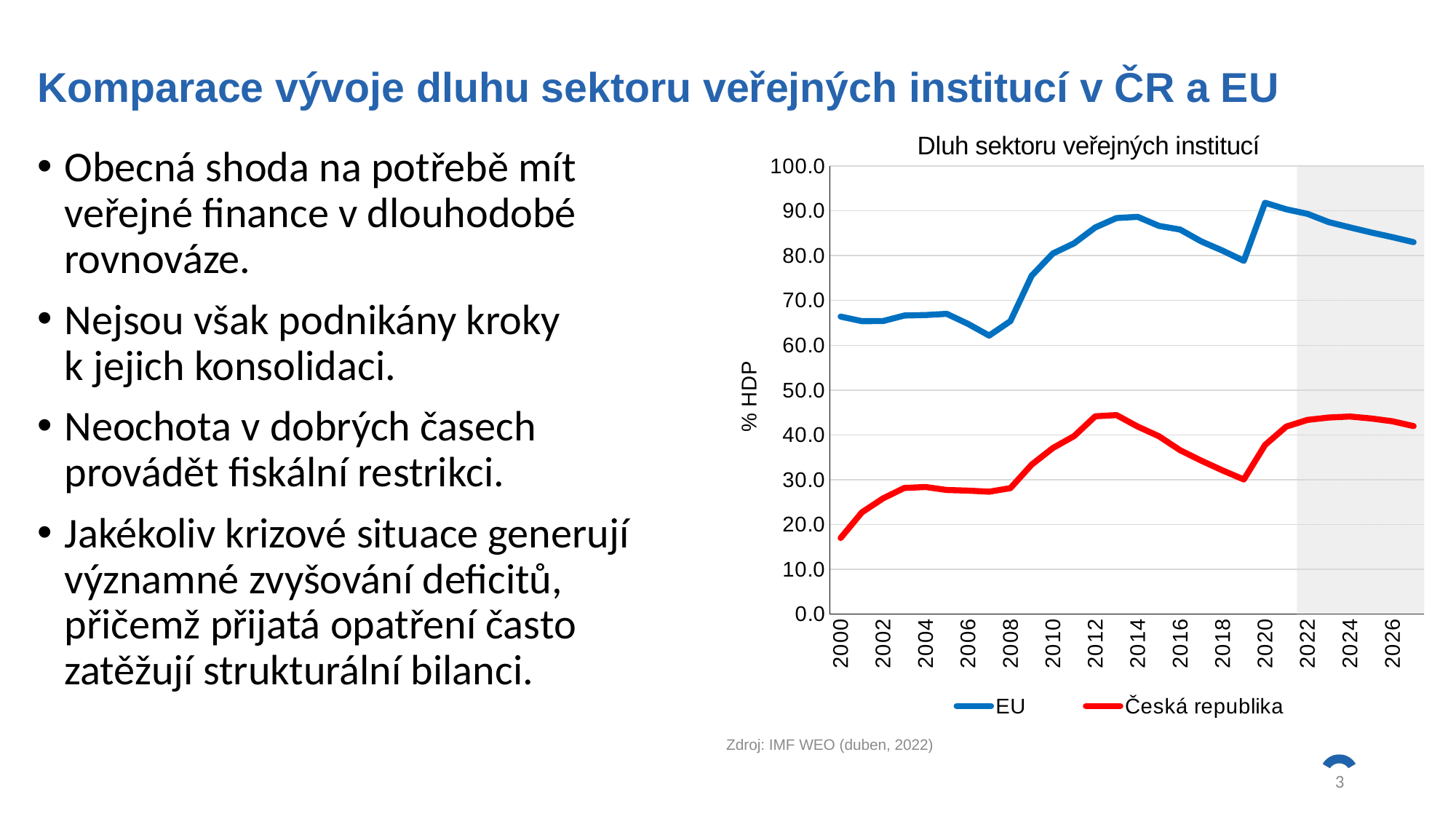
Is the value for EU in 2020 greater or less than 90? greater What kind of chart is shown on the slide? line chart Is the value for Česká republika in 2000 greater or less than 20? less Does the EU series rise or fall between 2020 and 2026? fall What is the title of the chart? Dluh sektoru veřejných institucí What are the two series named in the chart legend? EU and Česká republika Is the value for Česká republika in 2012 greater or less than 40? greater Which series has the higher value in 2010, EU or Česká republika? EU Does the Česká republika series rise or fall between 2000 and 2012? rise How many series does the legend of the chart list? 2